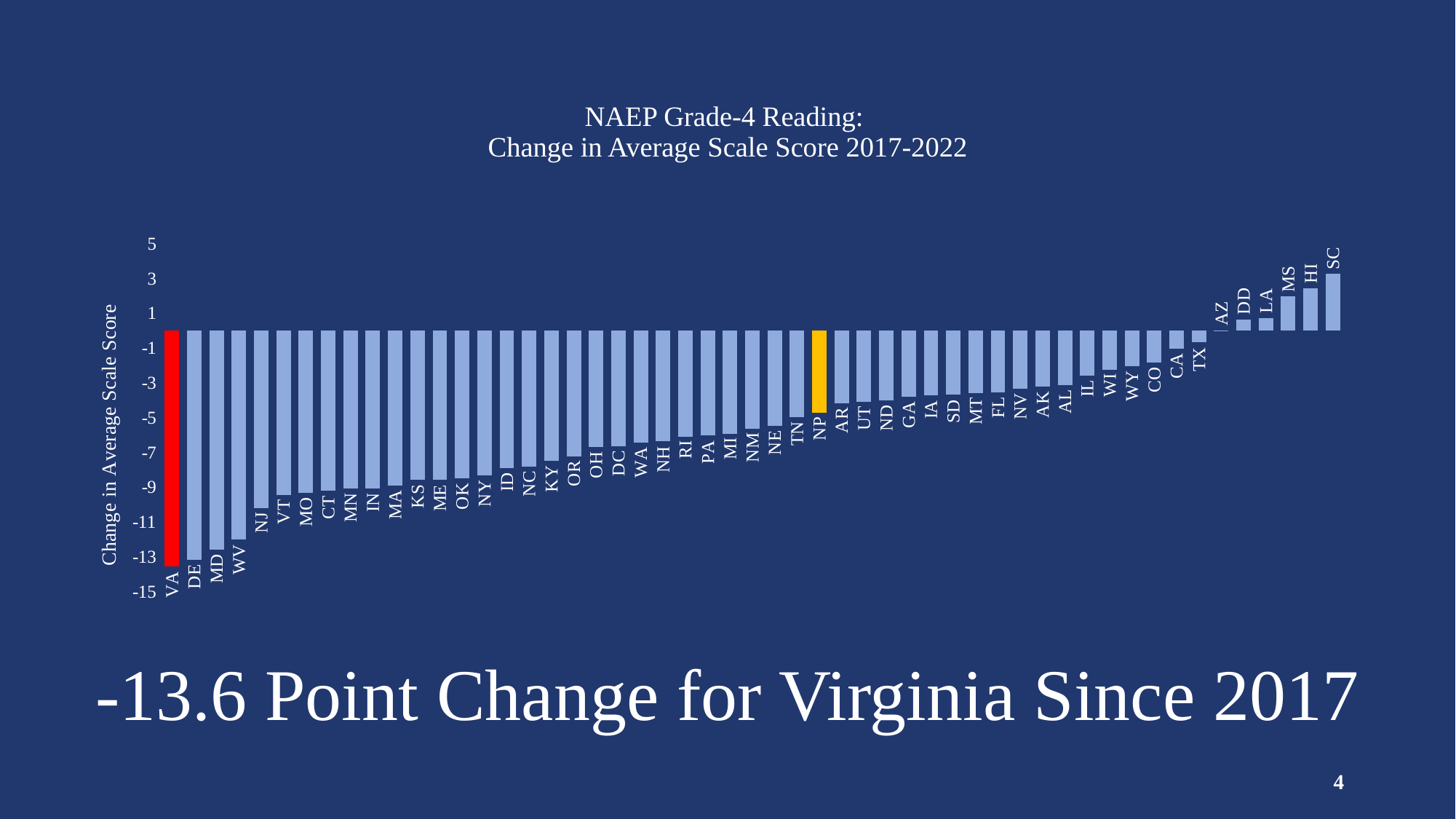
Which state has the lowest change in average scale score? VA What colour is the bar for VA? red Is the value for VA greater or less than -11? less Which state has the highest change in average scale score? SC Do the values rise or fall moving from left to right along the x axis? rise Which has the larger change in average scale score, VA or SC? SC Is the value for SC greater or less than 1? greater Is the value for WV greater or less than -11? less What kind of chart is shown on the slide? bar chart What is the title of the chart? NAEP Grade-4 Reading: Change in Average Scale Score 2017-2022 What is the point change in average scale score for Virginia (VA) since 2017? -13.6